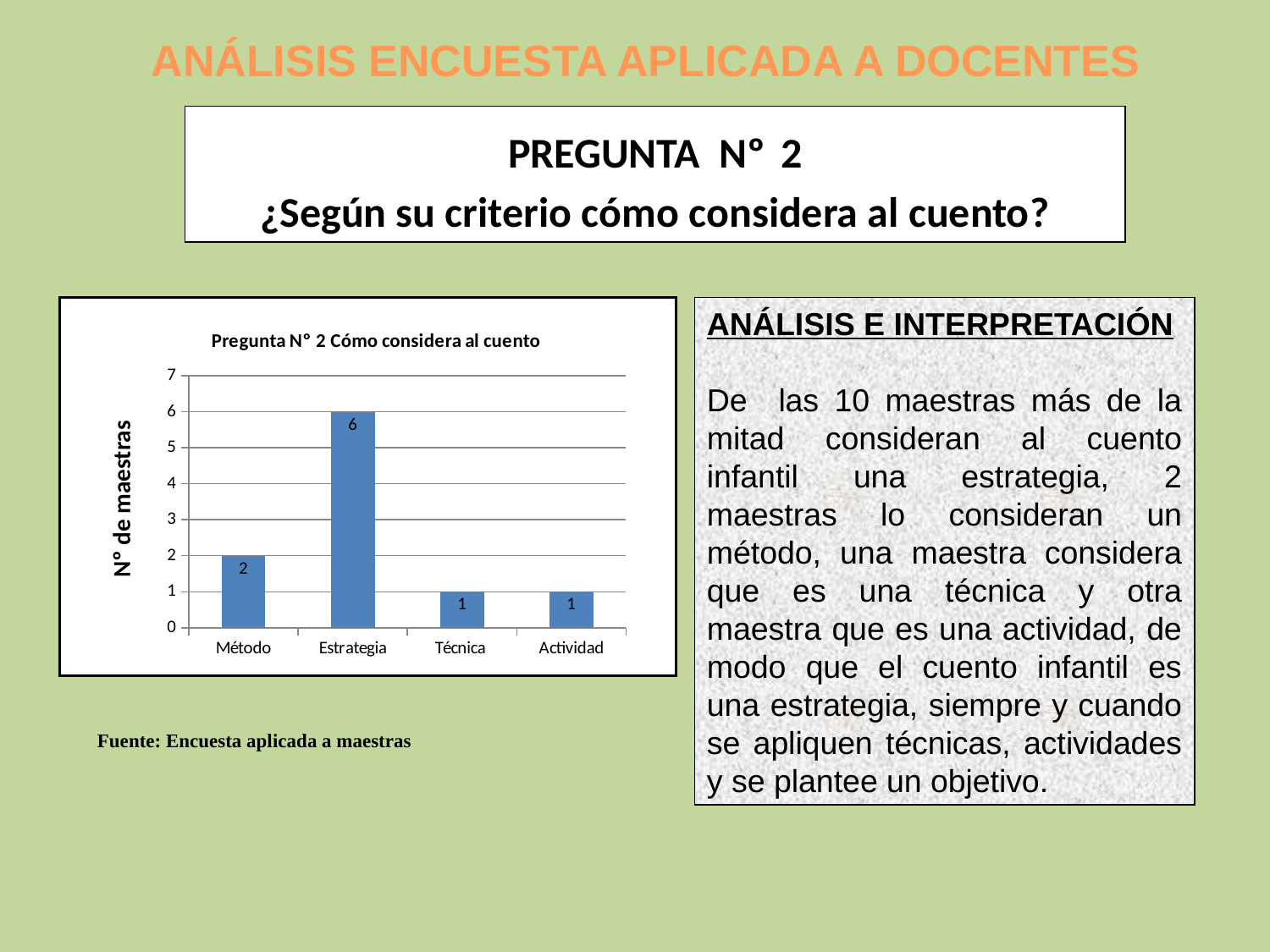
How many categories are shown on the x axis? 4 What is the value for Estrategia? 6 Which is larger, the value for Método or the value for Actividad? Método What is the title of the chart? Pregunta N° 2 Cómo considera al cuento What is the value for Técnica? 1 Which category has the highest value? Estrategia What is the value for Método? 2 What is the difference between the values for Estrategia and Método? 4 What is the total of all four bar values? 10 Is the value for Estrategia greater or less than 5? greater What kind of chart is shown? bar chart What is the label of the y axis? N° de maestras